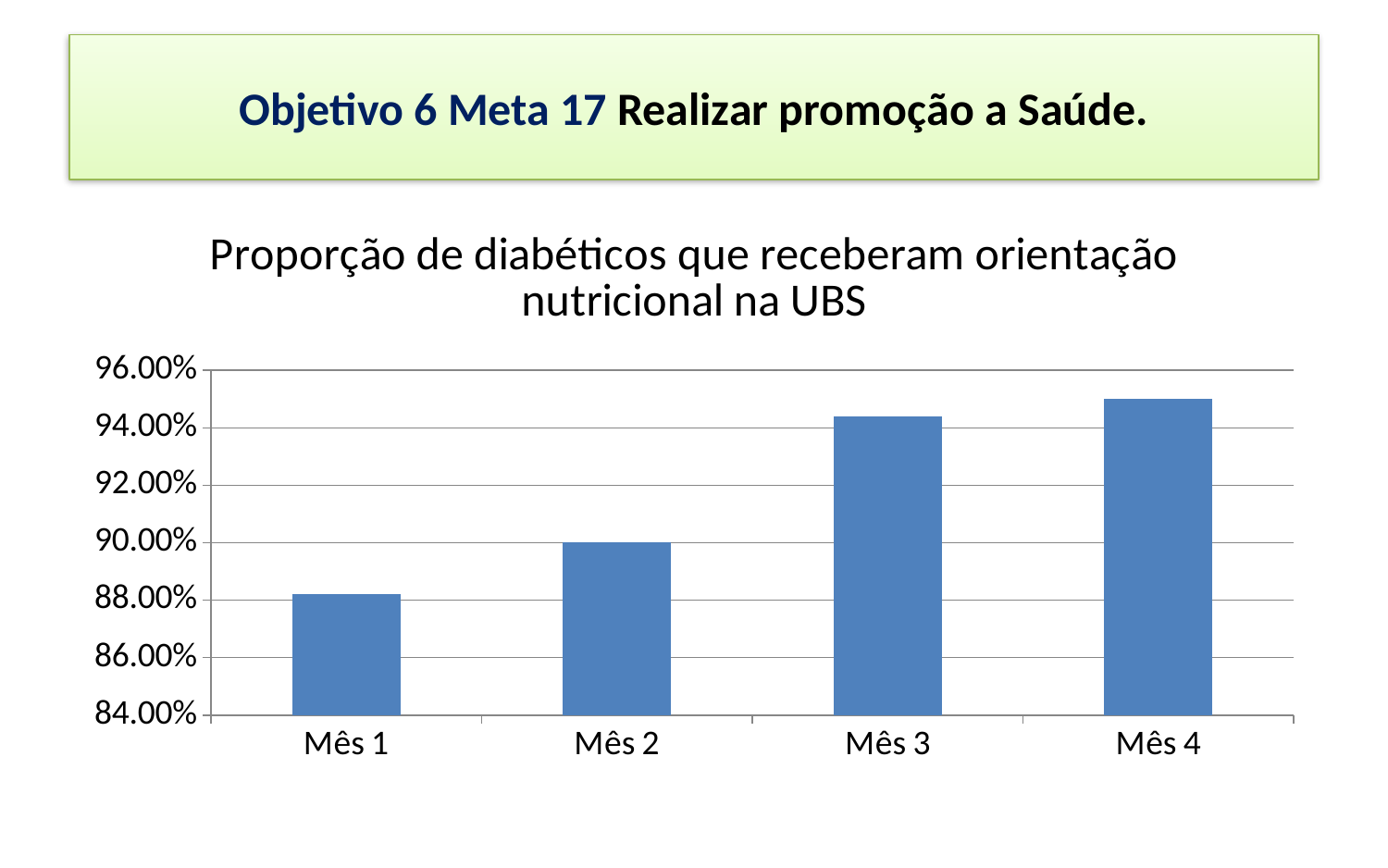
What is the title of the chart? Proporção de diabéticos que receberam orientação nutricional na UBS Which month has the highest proportion of diabetics who received nutritional guidance? Mês 4 What kind of chart is shown on the slide? bar chart Is the value for Mês 4 greater or less than 96.00%? less Which is larger, the value for Mês 2 or the value for Mês 3? Mês 3 Is the value for Mês 1 greater or less than 90.00%? less Do the values rise or fall from Mês 1 to Mês 4? rise Is the value for Mês 4 greater or less than 94.00%? greater How many months (categories) are plotted on the chart? 4 Which month has the lowest proportion of diabetics who received nutritional guidance? Mês 1 What is the lowest value shown on the vertical axis? 84.00%